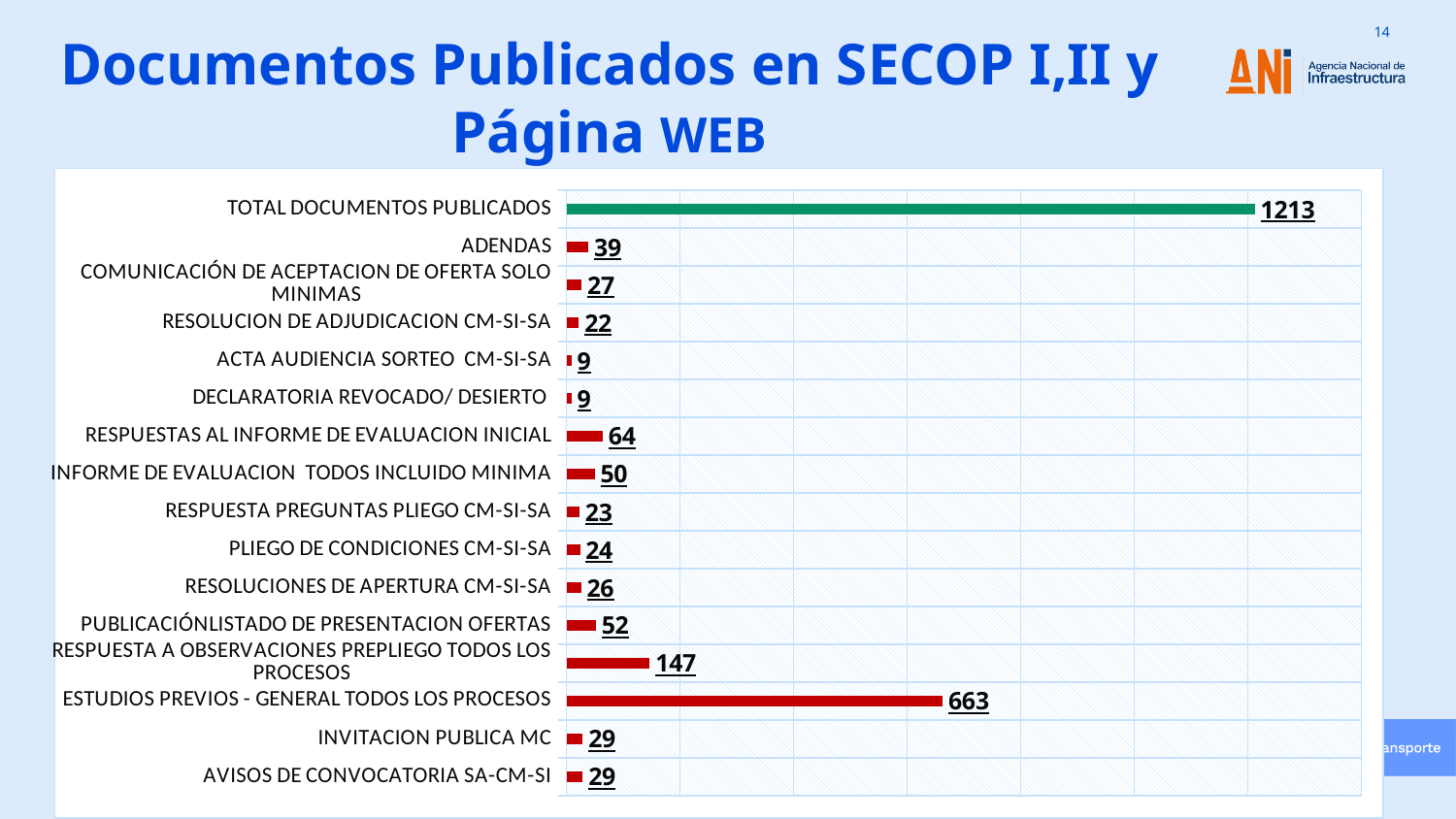
How many categories are shown in the chart? 16 What kind of chart is shown on the slide? Bar chart What is the value for INFORME DE EVALUACION TODOS INCLUIDO MINIMA? 50 What is the lowest value shown in the chart? 9 What colour is the bar for TOTAL DOCUMENTOS PUBLICADOS? Green What is the difference between ESTUDIOS PREVIOS - GENERAL TODOS LOS PROCESOS and RESPUESTA A OBSERVACIONES PREPLIEGO TODOS LOS PROCESOS? 516 What is the value for TOTAL DOCUMENTOS PUBLICADOS? 1213 What is the value for ADENDAS? 39 Excluding the TOTAL DOCUMENTOS PUBLICADOS bar, which category has the highest value? ESTUDIOS PREVIOS - GENERAL TODOS LOS PROCESOS What is the value for ESTUDIOS PREVIOS - GENERAL TODOS LOS PROCESOS? 663 What is the value for RESPUESTA A OBSERVACIONES PREPLIEGO TODOS LOS PROCESOS? 147 Which is larger, RESPUESTAS AL INFORME DE EVALUACION INICIAL or PUBLICACIÓNLISTADO DE PRESENTACION OFERTAS? RESPUESTAS AL INFORME DE EVALUACION INICIAL